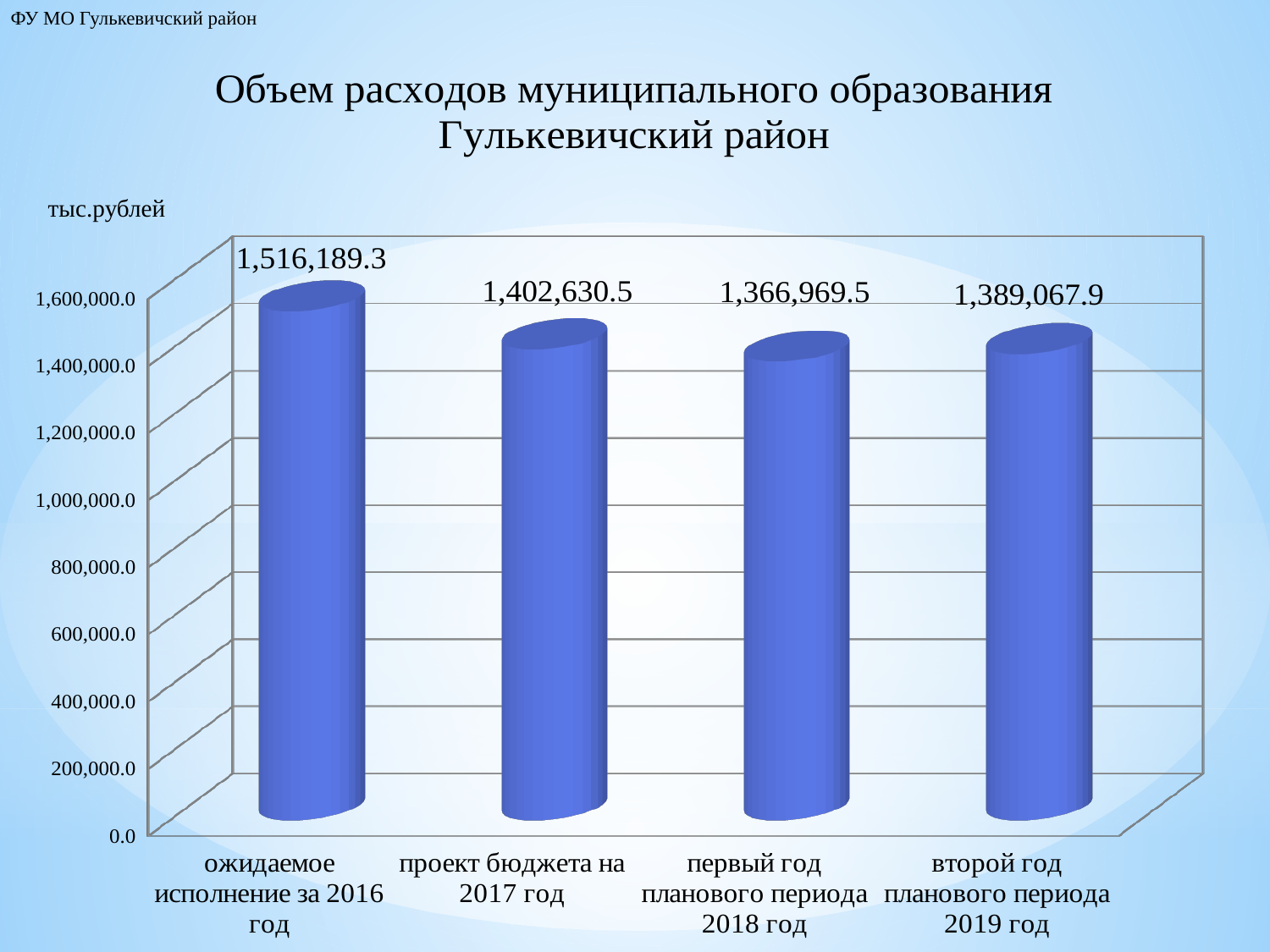
What is the difference between the values for 'ожидаемое исполнение за 2016 год' and 'проект бюджета на 2017 год'? 113,558.8 Which is larger: the value for 'проект бюджета на 2017 год' or the value for 'второй год планового периода 2019 год'? проект бюджета на 2017 год What is the value for 'проект бюджета на 2017 год'? 1,402,630.5 What is the value for 'ожидаемое исполнение за 2016 год'? 1,516,189.3 What is the difference between the values for 'второй год планового периода 2019 год' and 'первый год планового периода 2018 год'? 22,098.4 What kind of chart is shown on the slide? bar chart What is the value for 'второй год планового периода 2019 год'? 1,389,067.9 What is the value for 'первый год планового периода 2018 год'? 1,366,969.5 What unit is indicated above the vertical axis of the chart? тыс.рублей Which category has the highest value? ожидаемое исполнение за 2016 год How many categories are shown in the chart? 4 Which category has the lowest value? первый год планового периода 2018 год